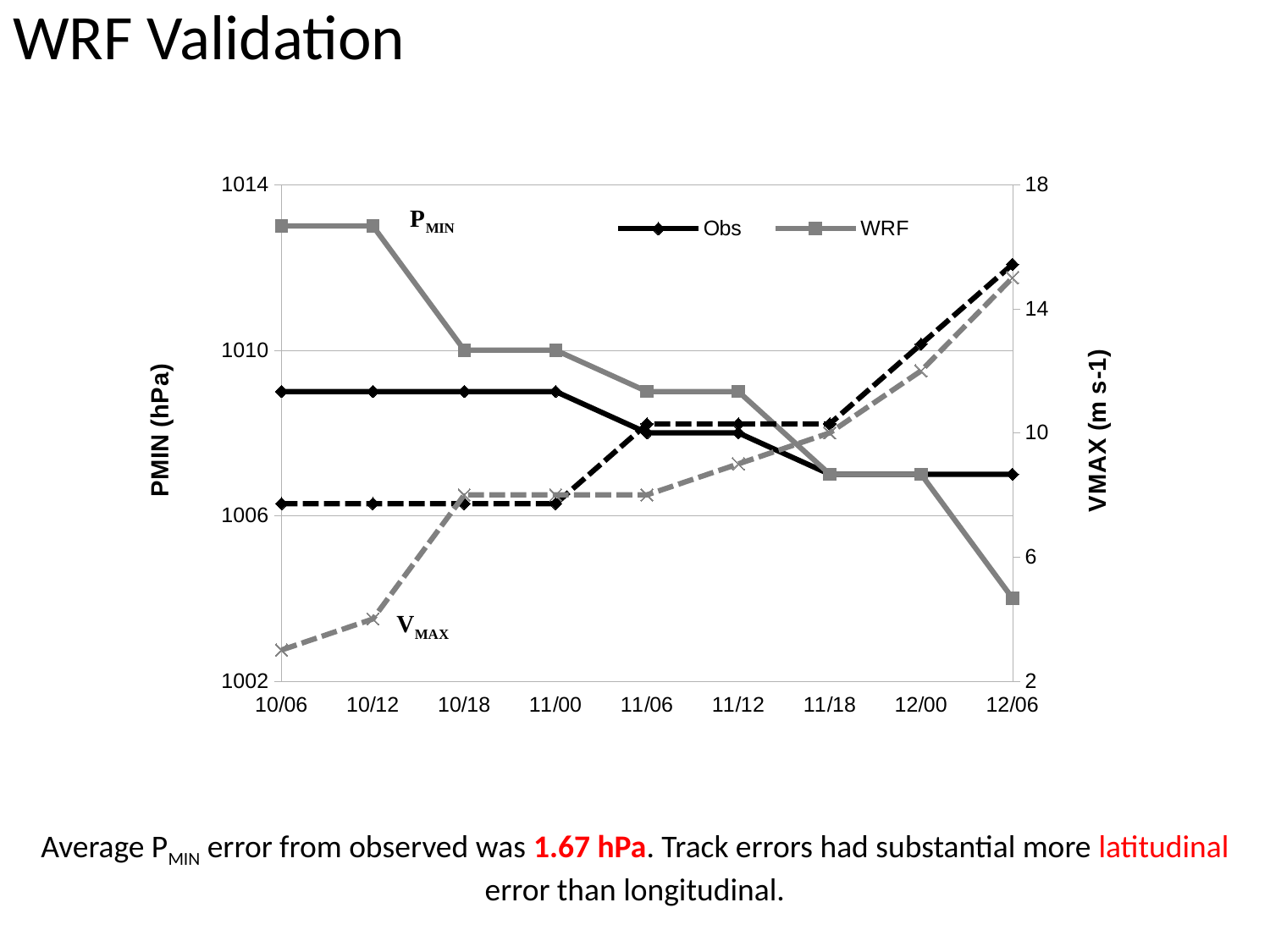
Is the Obs PMIN value at 10/06 greater or less than 1010? less At 10/06, which series has the higher PMIN, Obs or WRF? WRF What is the WRF PMIN value at 11/00? 1010 How many series does the chart legend list? 2 What kind of chart is shown on the slide? line chart Is the WRF PMIN value at 10/06 greater or less than 1010? greater At which time point is the WRF PMIN lowest? 12/06 What is the WRF PMIN value at 10/18? 1010 Is the WRF VMAX value at 10/06 greater or less than 6? less At which time point is the Obs VMAX highest? 12/06 How many time points are shown along the x axis? 9